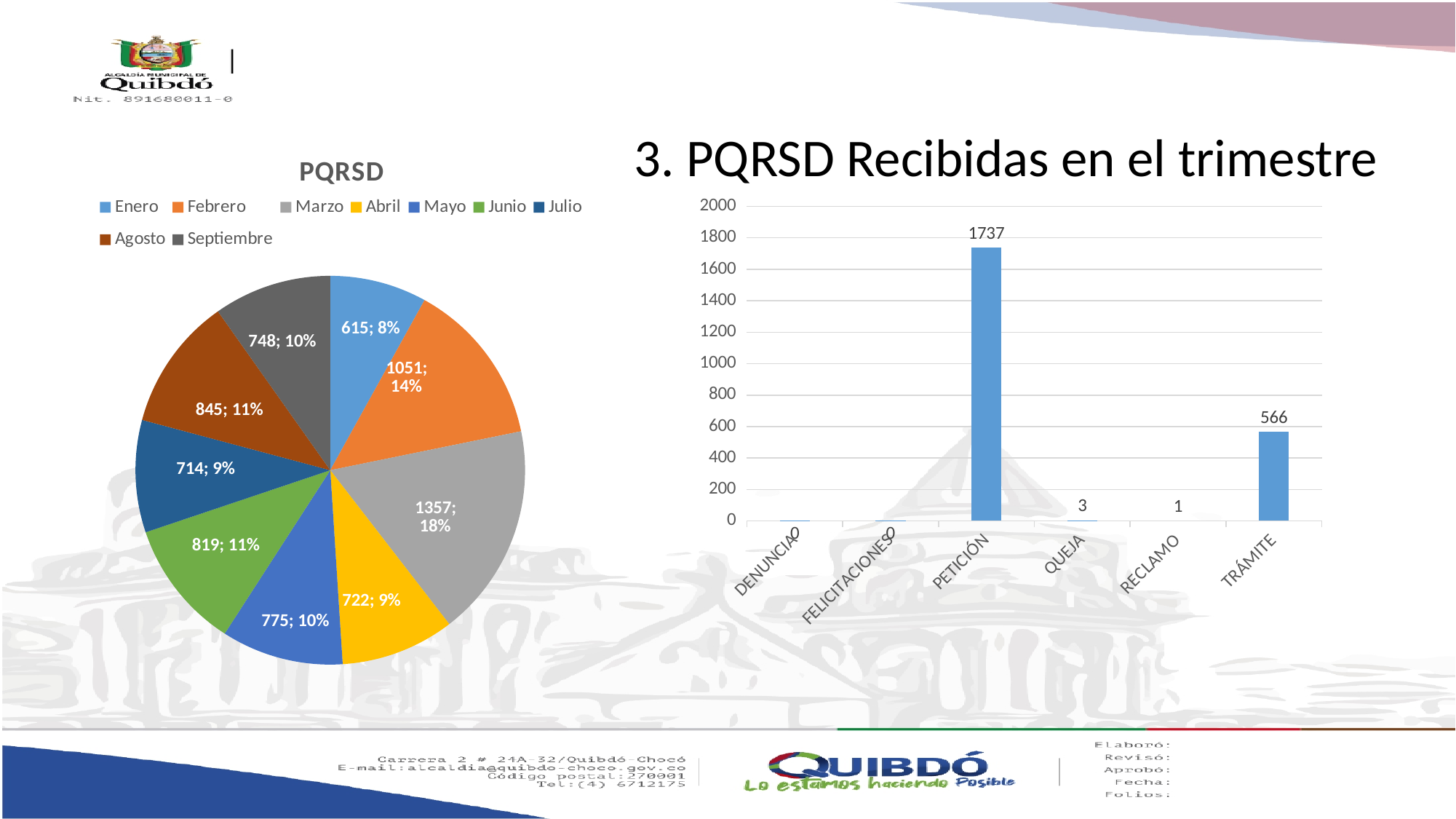
In the PQRSD pie chart, what is the value for Marzo? 1357; 18% In the PQRSD pie chart, what is the value for Enero? 615; 8% In the chart titled '3. PQRSD Recibidas en el trimestre', what is the value for PETICIÓN? 1737 In the PQRSD pie chart, what share of the pie does Febrero represent? 14% What kind of chart is '3. PQRSD Recibidas en el trimestre'? Bar chart In the chart titled '3. PQRSD Recibidas en el trimestre', what is the value for TRÁMITE? 566 In the PQRSD pie chart, which month has the largest slice? Marzo In the PQRSD pie chart, how many months does the legend list? 9 In the PQRSD pie chart, which is larger, Mayo or Abril? Mayo In the PQRSD pie chart, which month has the smallest slice? Enero In the chart titled '3. PQRSD Recibidas en el trimestre', what is the difference between PETICIÓN and TRÁMITE? 1171 In the PQRSD pie chart, what is the difference between the values for Agosto and Julio? 131